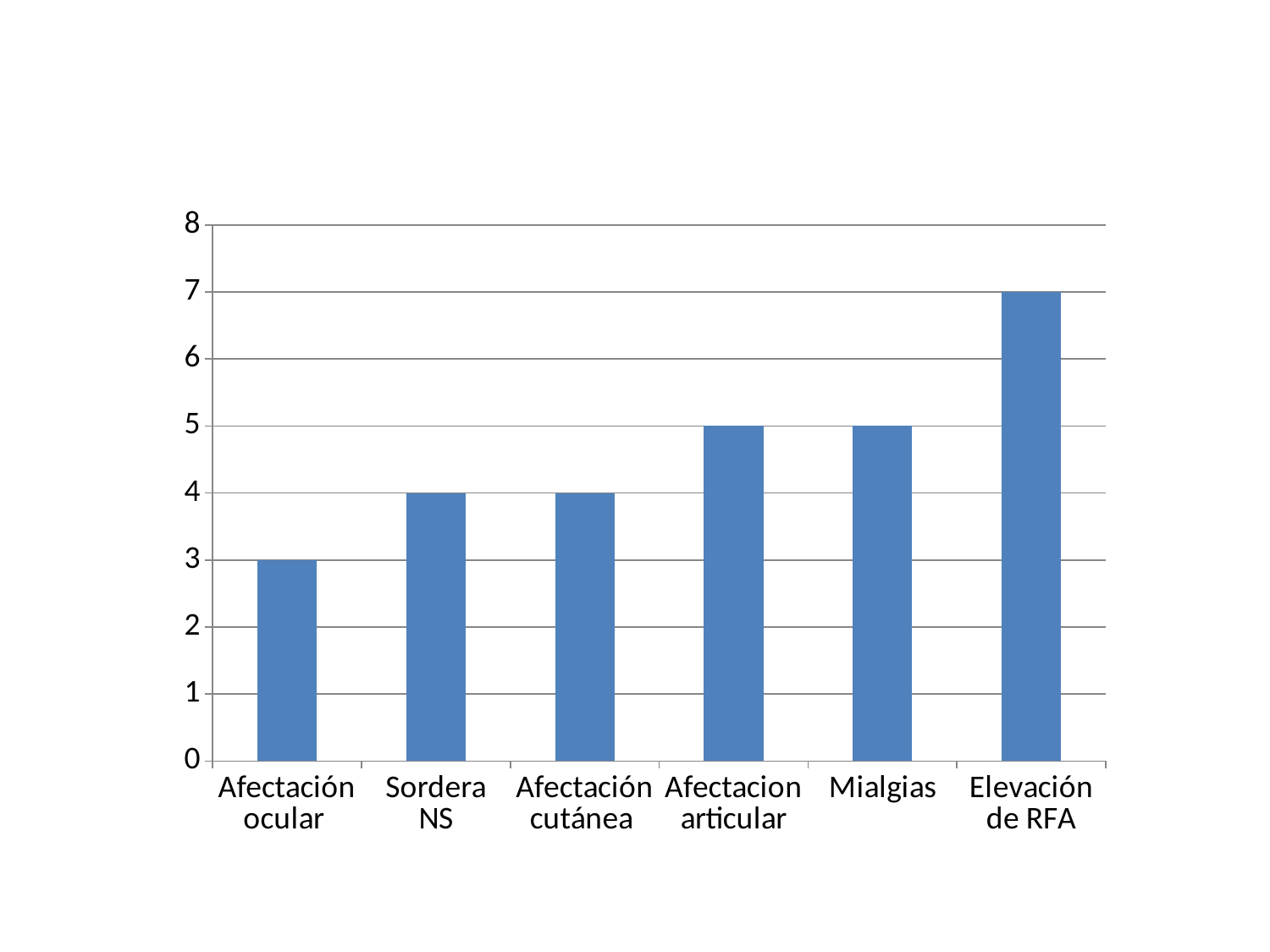
What kind of chart is shown on the slide? bar chart What is the value for Mialgias? 5 Which category has the highest value? Elevación de RFA What is the difference between the values for Elevación de RFA and Afectación ocular? 4 How many categories are shown on the x axis? 6 Which category has the lowest value? Afectación ocular Which is larger, the value for Mialgias or the value for Sordera NS? Mialgias What is the difference between the values for Afectacion articular and Afectación cutánea? 1 Is the value for Elevación de RFA greater or less than 6? greater What is the value for Afectación ocular? 3 What is the value for Elevación de RFA? 7 What is the value for Sordera NS? 4